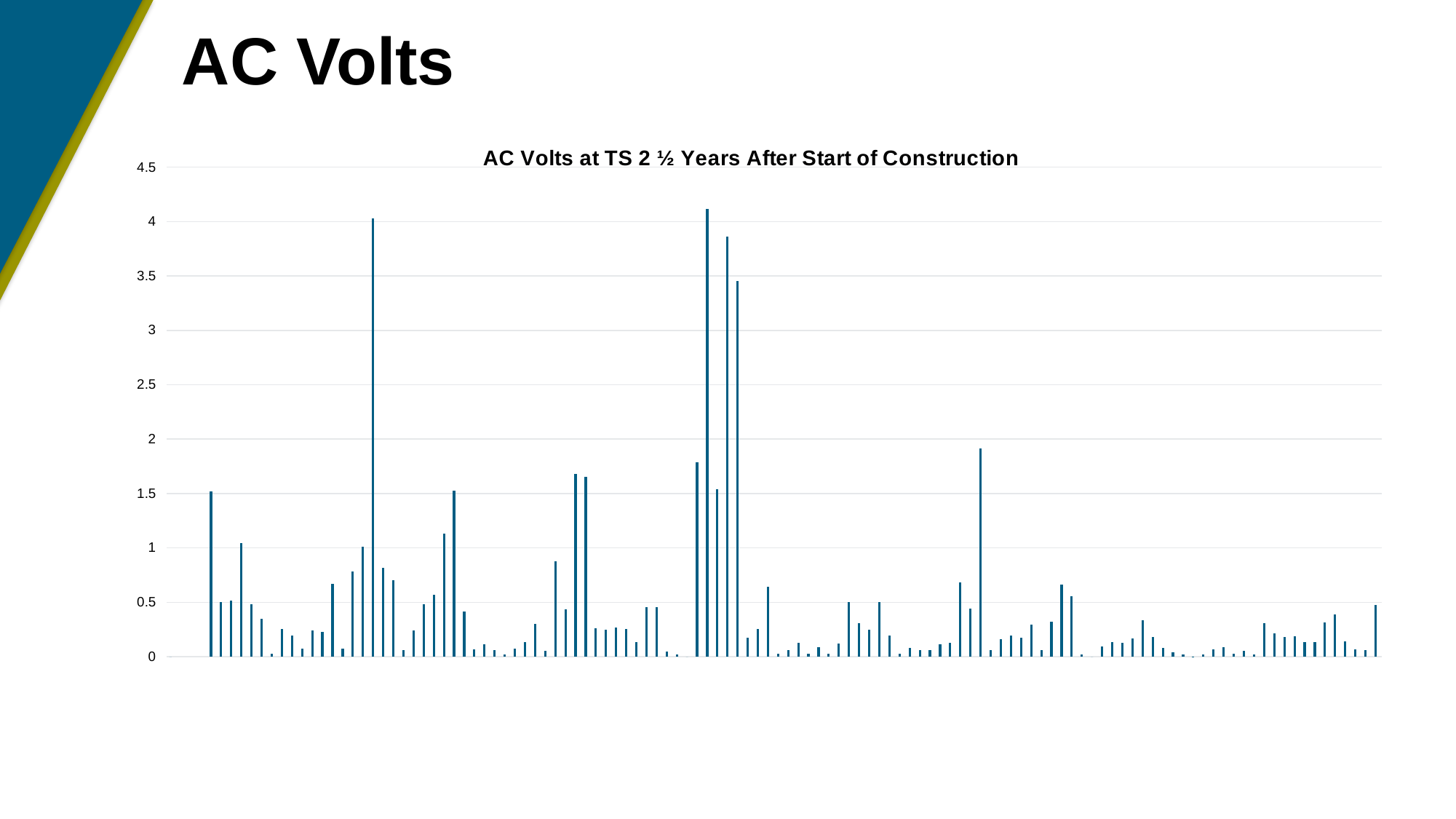
How many bars in the chart rise above the 2 gridline? 4 What is the spacing between consecutive tick labels on the vertical axis? 0.5 How many bars in the chart rise above the 3 gridline? 4 What kind of chart is shown on the slide? Bar chart Is the tallest bar in the chart greater or less than 4? greater What is the title of the chart? AC Volts at TS 2 ½ Years After Start of Construction Is the second-tallest bar in the chart greater or less than 3.5? greater What is the highest value labelled on the vertical axis of the chart? 4.5 Is the tallest bar in the chart greater or less than 4.5? less